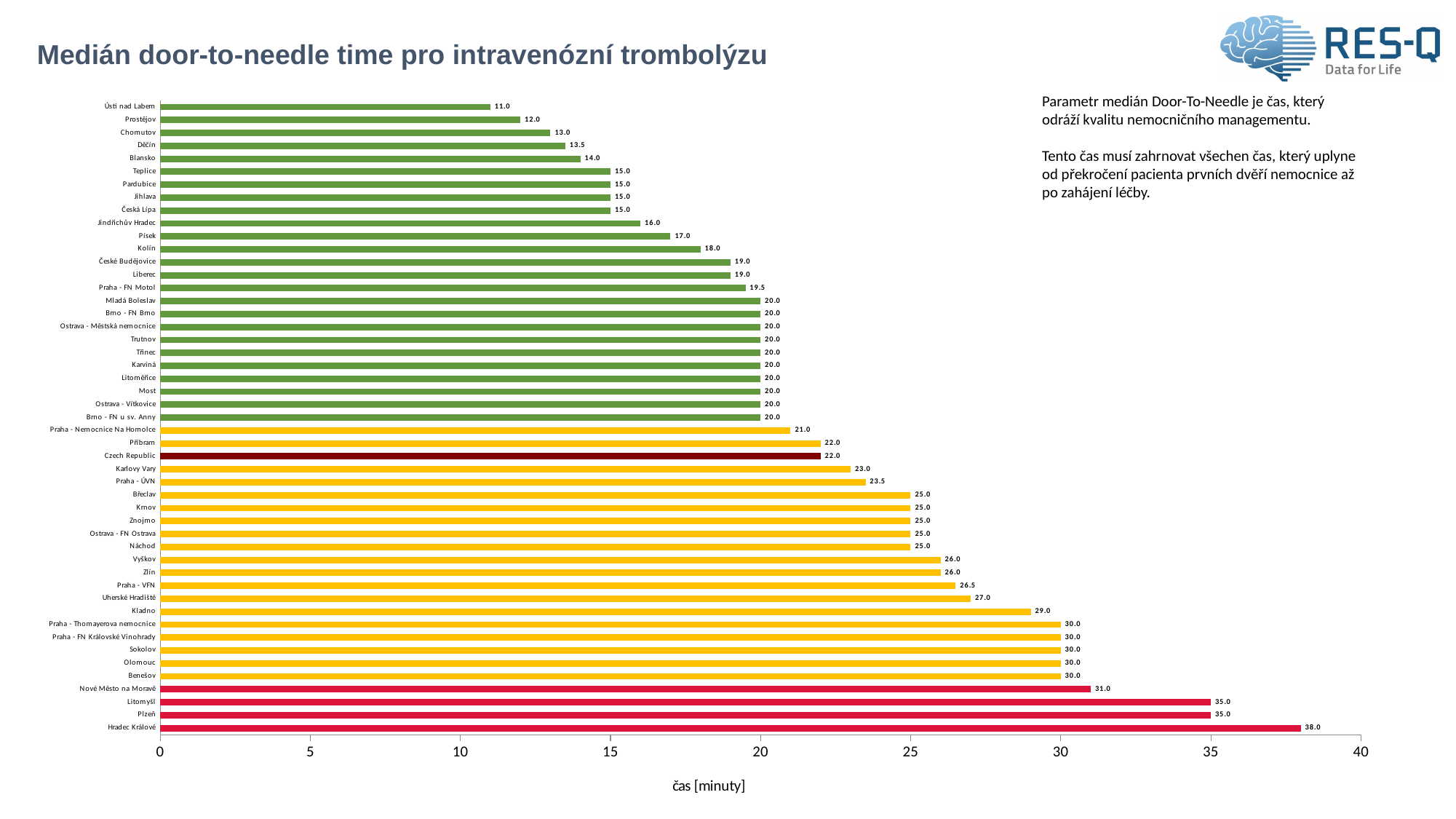
Which hospital has the highest median door-to-needle time? Hradec Králové Which hospital has the lowest median door-to-needle time? Ústí nad Labem What is the value shown for Praha - FN Motol? 19.5 What is the median door-to-needle time for Hradec Králové? 38.0 What kind of chart is shown on the slide? bar chart What is the value shown for Czech Republic? 22.0 Which has a larger value, Plzeň or Nové Město na Moravě? Plzeň What is the difference between the values for Hradec Králové and Ústí nad Labem? 27.0 What is the difference between the values for Kladno and Czech Republic? 7.0 Which has a larger value, Písek or Kolín? Kolín Is the value for Benešov greater or less than 25? greater What is the label of the horizontal axis? čas [minuty]